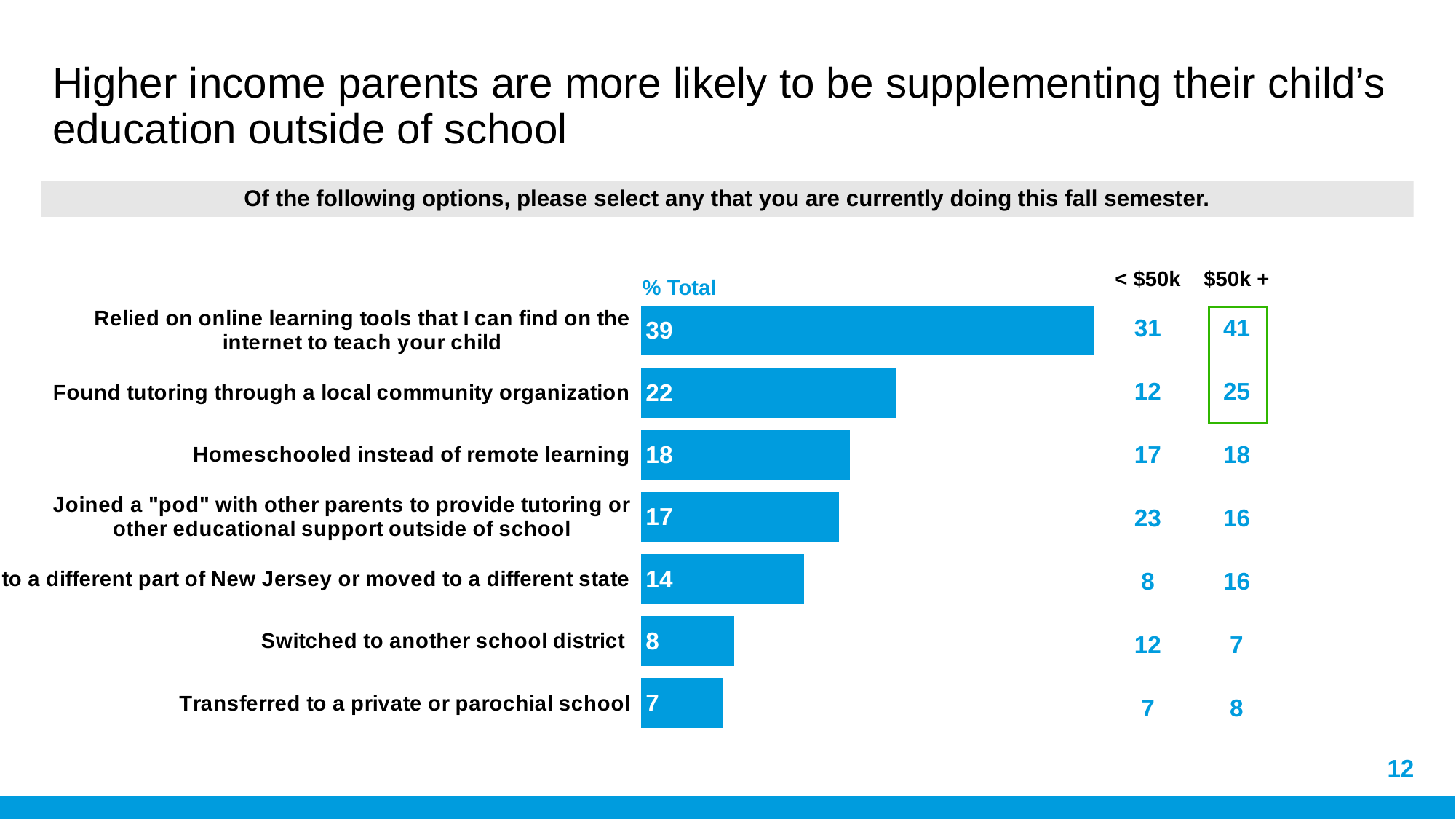
In the $50k + column, what is the value for "Found tutoring through a local community organization"? 25 Which has a larger % Total: "Switched to another school district" or "Homeschooled instead of remote learning"? Homeschooled instead of remote learning What type of chart is shown on the slide? bar chart What is the difference in % Total between "Relied on online learning tools that I can find on the internet to teach your child" and "Found tutoring through a local community organization"? 17 How many categories (options) are plotted in the bar chart? 7 What is the % Total value for "Relied on online learning tools that I can find on the internet to teach your child"? 39 What is the % Total value for "Homeschooled instead of remote learning"? 18 What is the label shown above the bars in the chart? % Total Which option has the highest % Total value? Relied on online learning tools that I can find on the internet to teach your child What is the % Total value for "Transferred to a private or parochial school"? 7 What is the % Total value for "Found tutoring through a local community organization"? 22 Which option has the lowest % Total value? Transferred to a private or parochial school